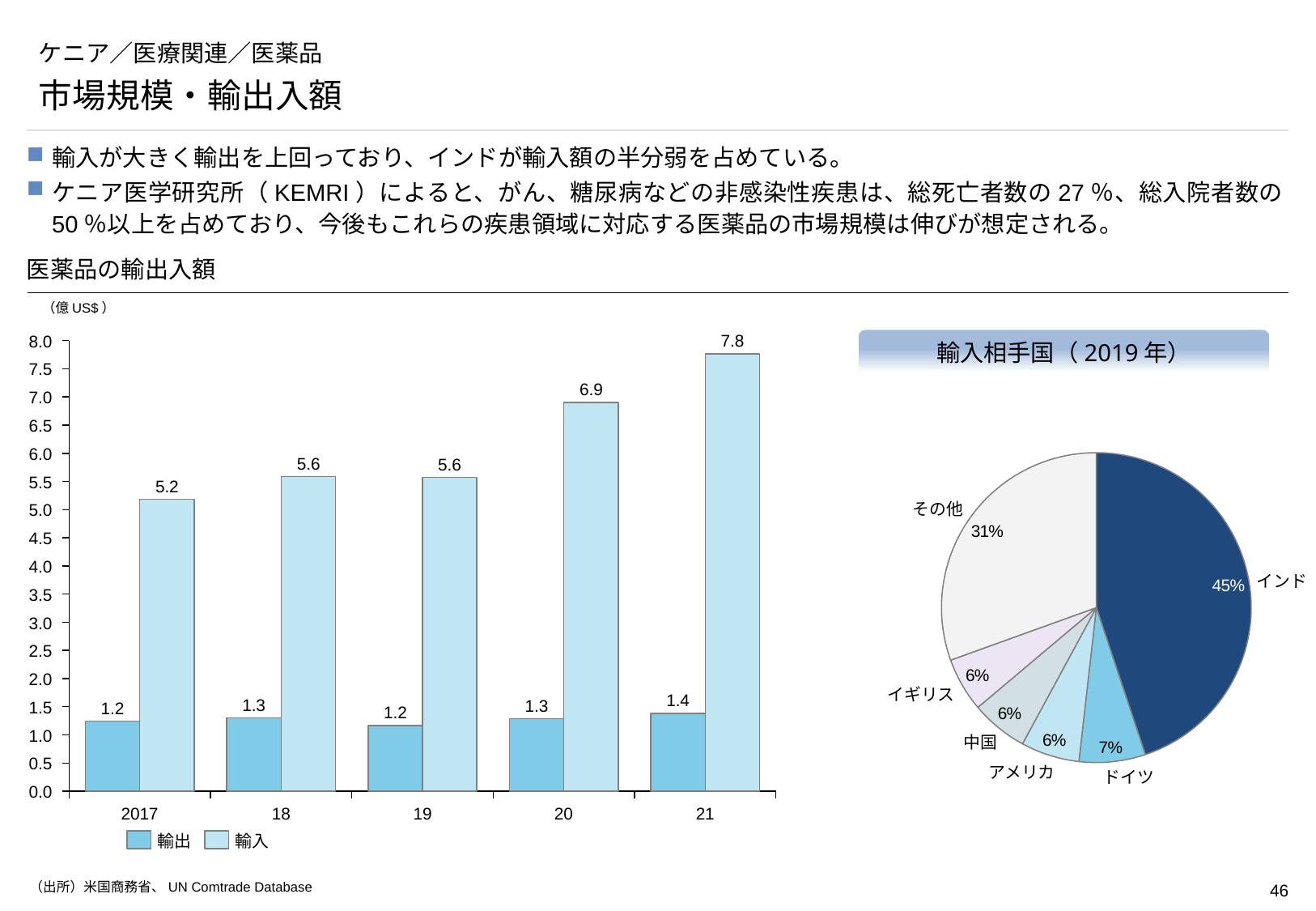
In the pie chart 輸入相手国（2019年）, which category has the largest share? インド In the bar chart 医薬品の輸出入額, what is the value of 輸入 for 2017? 5.2 In the pie chart 輸入相手国（2019年）, what share does インド have? 45% In the bar chart 医薬品の輸出入額, how many series does the legend list? 2 In the bar chart 医薬品の輸出入額, what is the difference between 輸入 and 輸出 in 20? 5.6 In the bar chart 医薬品の輸出入額, how many years are shown on the x axis? 5 In the pie chart 輸入相手国（2019年）, what share does ドイツ have? 7% In the bar chart 医薬品の輸出入額, what is the value of 輸出 for 21? 1.4 What kind of chart is the chart on the left of the slide? bar chart In the bar chart 医薬品の輸出入額, is the 輸入 value for 19 greater or less than the 輸入 value for 20? less In the bar chart 医薬品の輸出入額, which year has the highest 輸入 value? 21 In the bar chart 医薬品の輸出入額, does the 輸入 value rise or fall from 19 to 21? rise